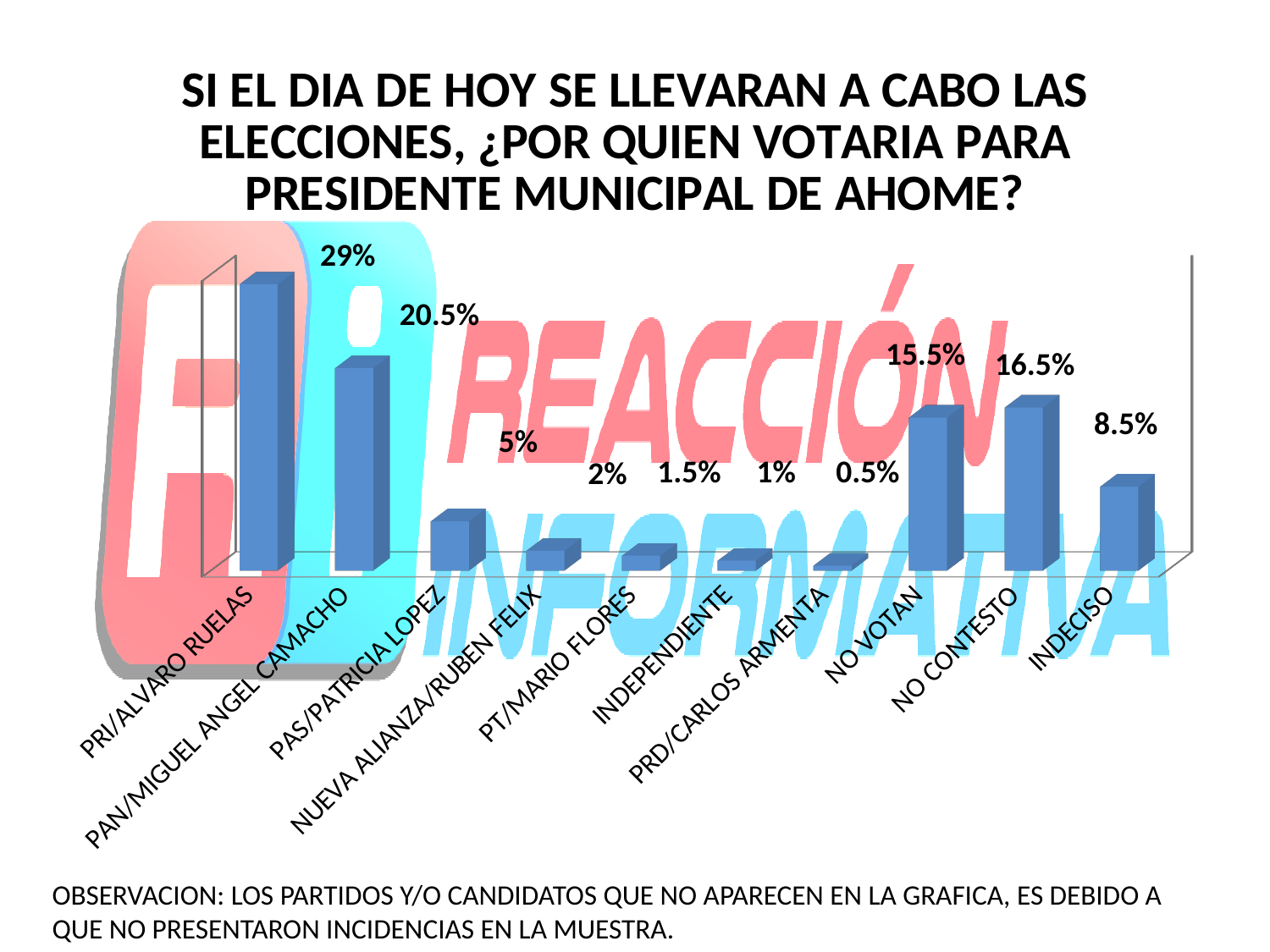
What percentage is shown for PRI/ALVARO RUELAS? 29% Which category has the lowest value? PRD/CARLOS ARMENTA What percentage is shown for INDECISO? 8.5% Which category has the highest value? PRI/ALVARO RUELAS What percentage is shown for NO CONTESTO? 16.5% How many categories are shown in the chart? 10 What is the difference between the values for NO CONTESTO and INDECISO? 8% What percentage is shown for PAN/MIGUEL ANGEL CAMACHO? 20.5% What kind of chart is shown on the slide? Bar chart Which is larger, the value for NO VOTAN or the value for NO CONTESTO? NO CONTESTO What percentage is shown for PAS/PATRICIA LOPEZ? 5% What is the difference between the values for PRI/ALVARO RUELAS and PAN/MIGUEL ANGEL CAMACHO? 8.5%